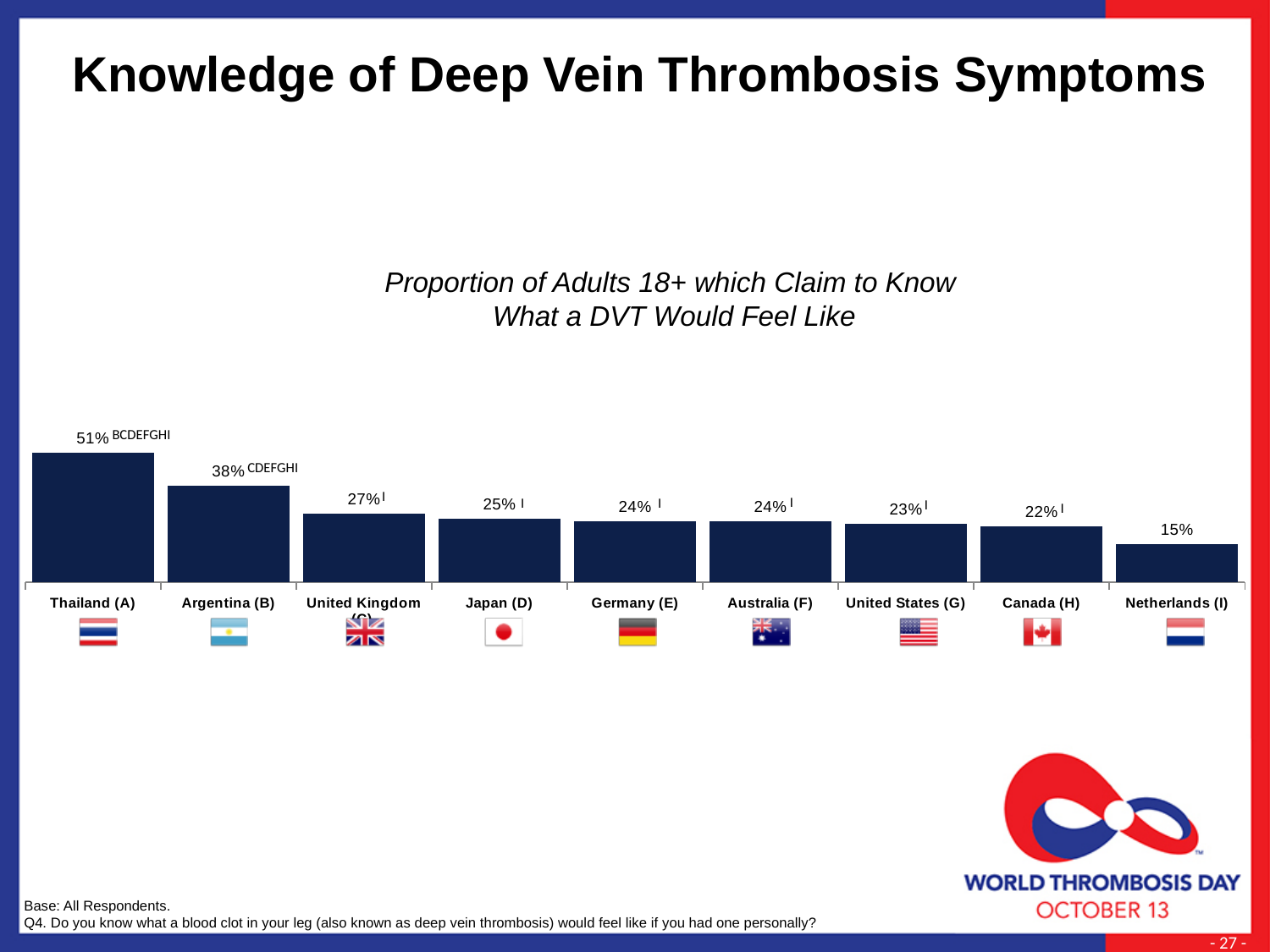
Which is larger, the value for Japan (D) or the value for Canada (H)? Japan (D) What is the value for Canada (H)? 22% What is the difference between the values for United Kingdom (C) and Netherlands (I)? 12% What is the difference between the values for Thailand (A) and Argentina (B)? 13% What is the value for Netherlands (I)? 15% How many countries are shown in the chart? 9 Which country has the highest proportion of adults claiming to know what a DVT would feel like? Thailand (A) Which country has the lowest proportion of adults claiming to know what a DVT would feel like? Netherlands (I) What is the title of the chart? Proportion of Adults 18+ which Claim to Know What a DVT Would Feel Like What is the value for Argentina (B)? 38% What kind of chart is shown on the slide? Bar chart What is the value for Thailand (A)? 51%